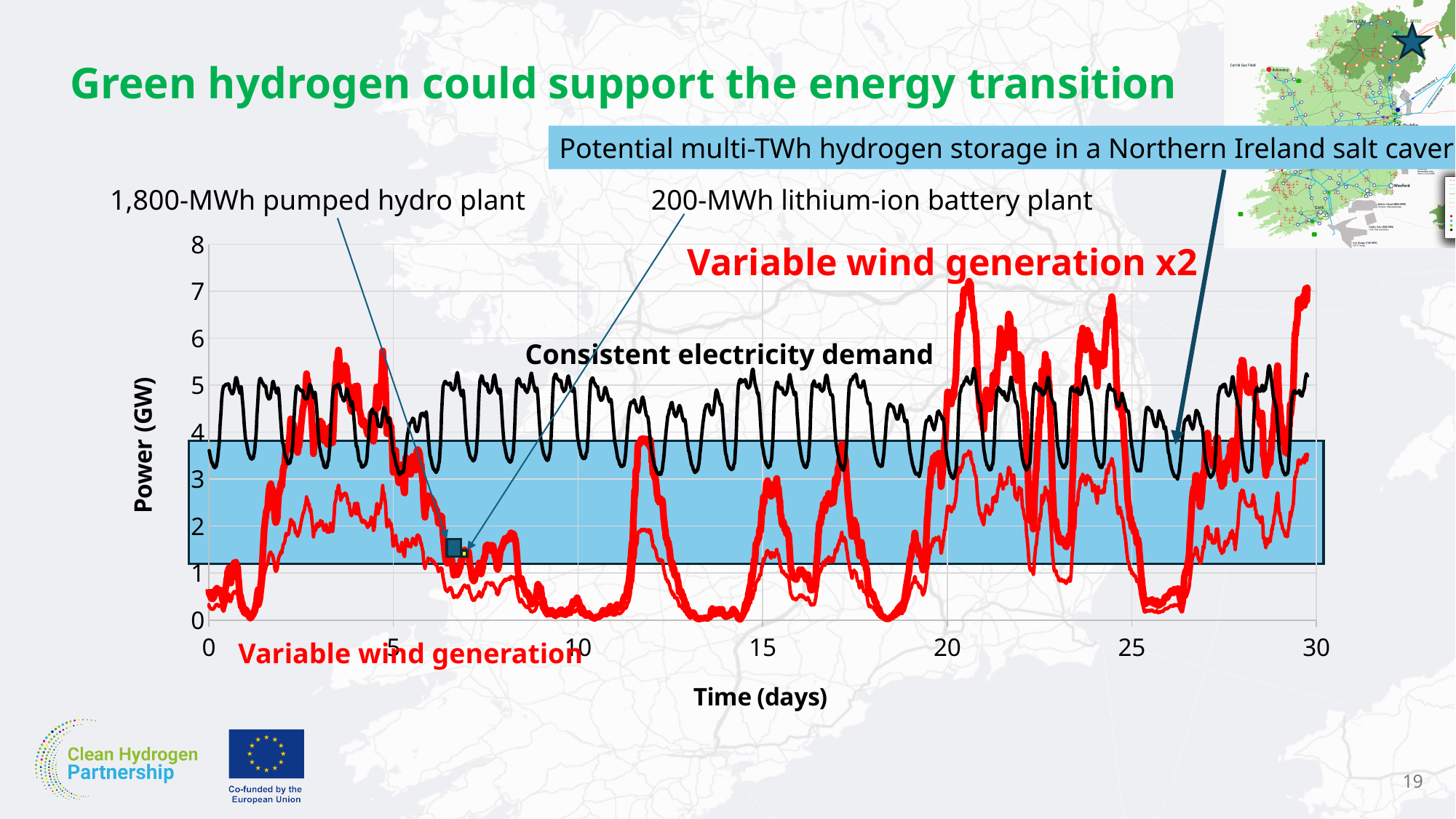
Which line has the lowest minimum value: Consistent electricity demand or Variable wind generation? Variable wind generation Is the lowest value of the Consistent electricity demand line greater or less than 2? greater What is the label of the y axis of the chart? Power (GW) What is the highest value shown on the y axis of the chart? 8 Is the peak value of the Variable wind generation x2 line greater or less than 6? greater Is the highest value of the Consistent electricity demand line greater or less than 6? less How many lines (series) are plotted on the chart? 3 What is the label of the x axis of the chart? Time (days) What is the highest value shown on the x axis of the chart? 30 Which line reaches a higher peak value: Consistent electricity demand or Variable wind generation x2? Variable wind generation x2 What kind of chart is shown on the slide? Line chart